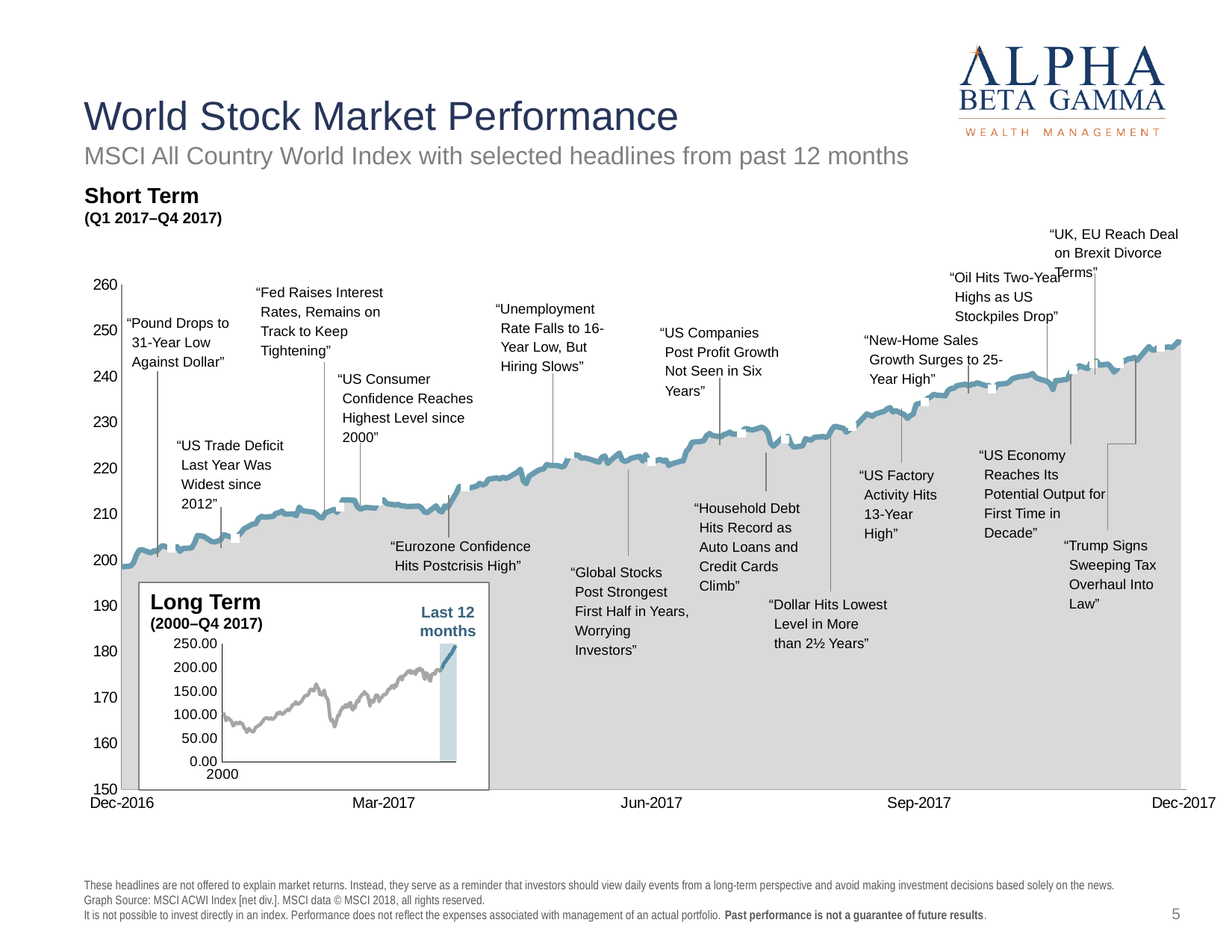
What is the highest value shown on the y axis of the Short Term chart? 260 In the Short Term chart, which is larger, the value at Dec-2016 or the value at Dec-2017? Dec-2017 In the Short Term chart, is the value at Jun-2017 greater or less than 210? greater In the Short Term chart, how many date labels are shown on the x axis? 5 What kind of chart is the Short Term chart on the slide? area and line chart In the Long Term inset chart, do the values generally rise or fall from 2000 to Q4 2017? rise In the Short Term chart, is the value at Dec-2017 greater or less than 240? greater In the Short Term chart, do the values generally rise or fall from Dec-2016 to Dec-2017? rise In the Short Term chart, is the value at Dec-2016 greater or less than 210? less What period does the Long Term inset chart cover, according to its subtitle? 2000–Q4 2017